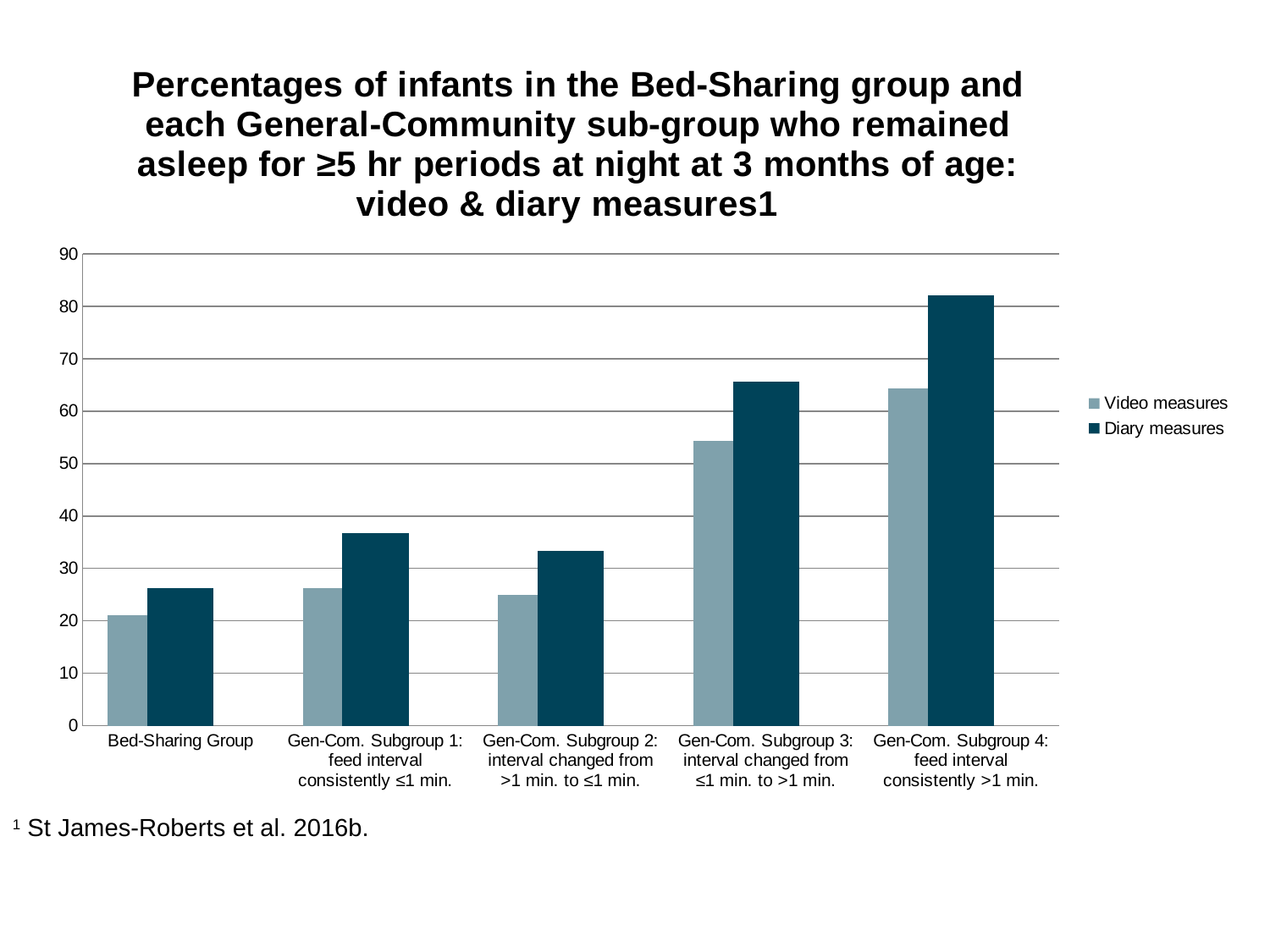
Which is larger for Diary measures: Gen-Com. Subgroup 1 or Gen-Com. Subgroup 2? Gen-Com. Subgroup 1 How many series does the legend list? 2 How many groups are shown along the x axis? 5 Is the Video measures value for Gen-Com. Subgroup 3 greater or less than 50? greater Is the Diary measures value for Gen-Com. Subgroup 4 greater or less than 70? greater Which series is shown in the darker colour in the legend? Diary measures What kind of chart is shown on the slide? bar chart Which group has the lowest value for Video measures? Bed-Sharing Group Is the Video measures value for the Bed-Sharing Group greater or less than 30? less Which group has the highest value for Video measures? Gen-Com. Subgroup 4: feed interval consistently >1 min. Which group has the highest value for Diary measures? Gen-Com. Subgroup 4: feed interval consistently >1 min.